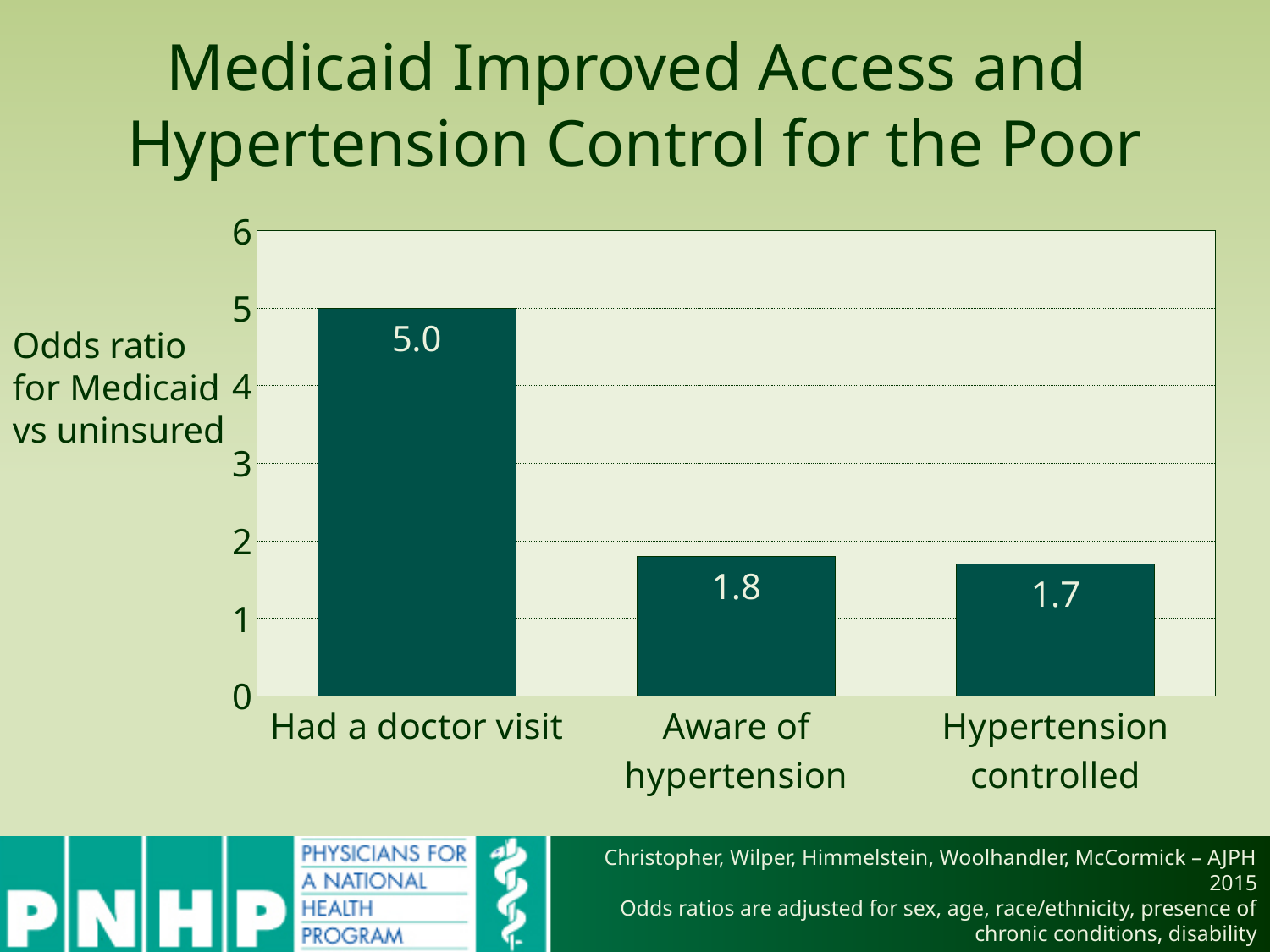
Which category has the highest odds ratio? Had a doctor visit What kind of chart is shown on the slide? Bar chart Which category has the lowest odds ratio? Hypertension controlled Is the odds ratio for 'Aware of hypertension' greater or less than 2? less What is the odds ratio for 'Aware of hypertension'? 1.8 What is the odds ratio for 'Had a doctor visit'? 5.0 Which is larger, the odds ratio for 'Had a doctor visit' or for 'Hypertension controlled'? Had a doctor visit What does the y-axis of the chart represent? Odds ratio for Medicaid vs uninsured What is the odds ratio for 'Hypertension controlled'? 1.7 What is the difference between the odds ratio for 'Had a doctor visit' and 'Aware of hypertension'? 3.2 What is the difference between the odds ratio for 'Aware of hypertension' and 'Hypertension controlled'? 0.1 How many categories are shown on the chart? 3